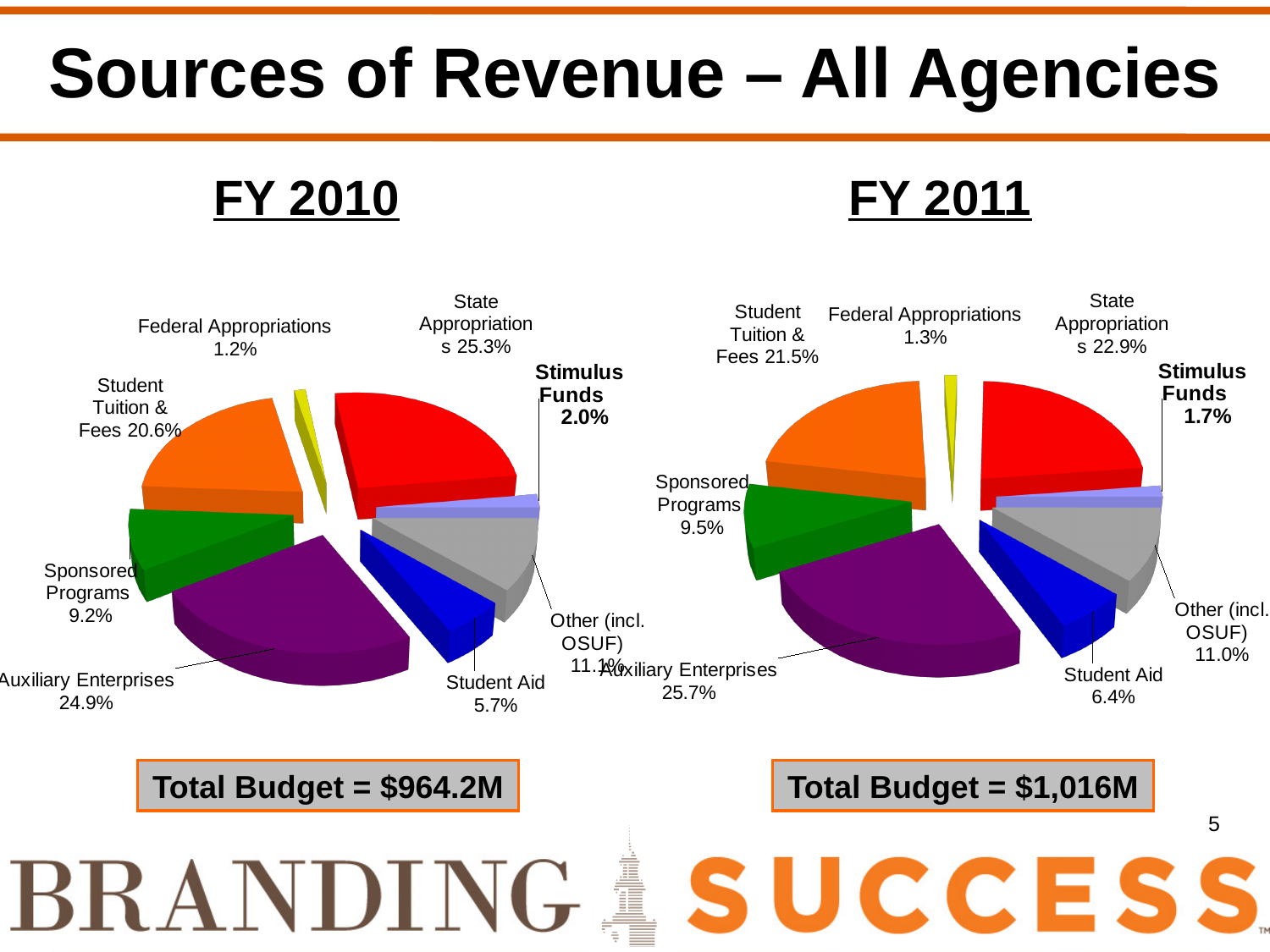
In the FY 2010 pie chart, which source has the smallest share? Federal Appropriations In the FY 2011 pie chart, which is larger: Sponsored Programs or Student Aid? Sponsored Programs What is the difference between the Student Tuition & Fees share in FY 2011 and in FY 2010? 0.9% What total budget is shown below the FY 2011 chart? $1,016M In the FY 2010 pie chart, what is the value for Student Aid? 5.7% In the FY 2010 pie chart, which source has the largest share? State Appropriations In the FY 2011 pie chart, which source has the largest share? Auxiliary Enterprises In the FY 2011 pie chart, what is the value for Stimulus Funds? 1.7% In the FY 2010 pie chart, what share of revenue comes from State Appropriations? 25.3% What type of chart is used for FY 2011? Pie chart In the FY 2011 pie chart, what share of revenue comes from Auxiliary Enterprises? 25.7% How many slices does the FY 2010 pie chart have? 8